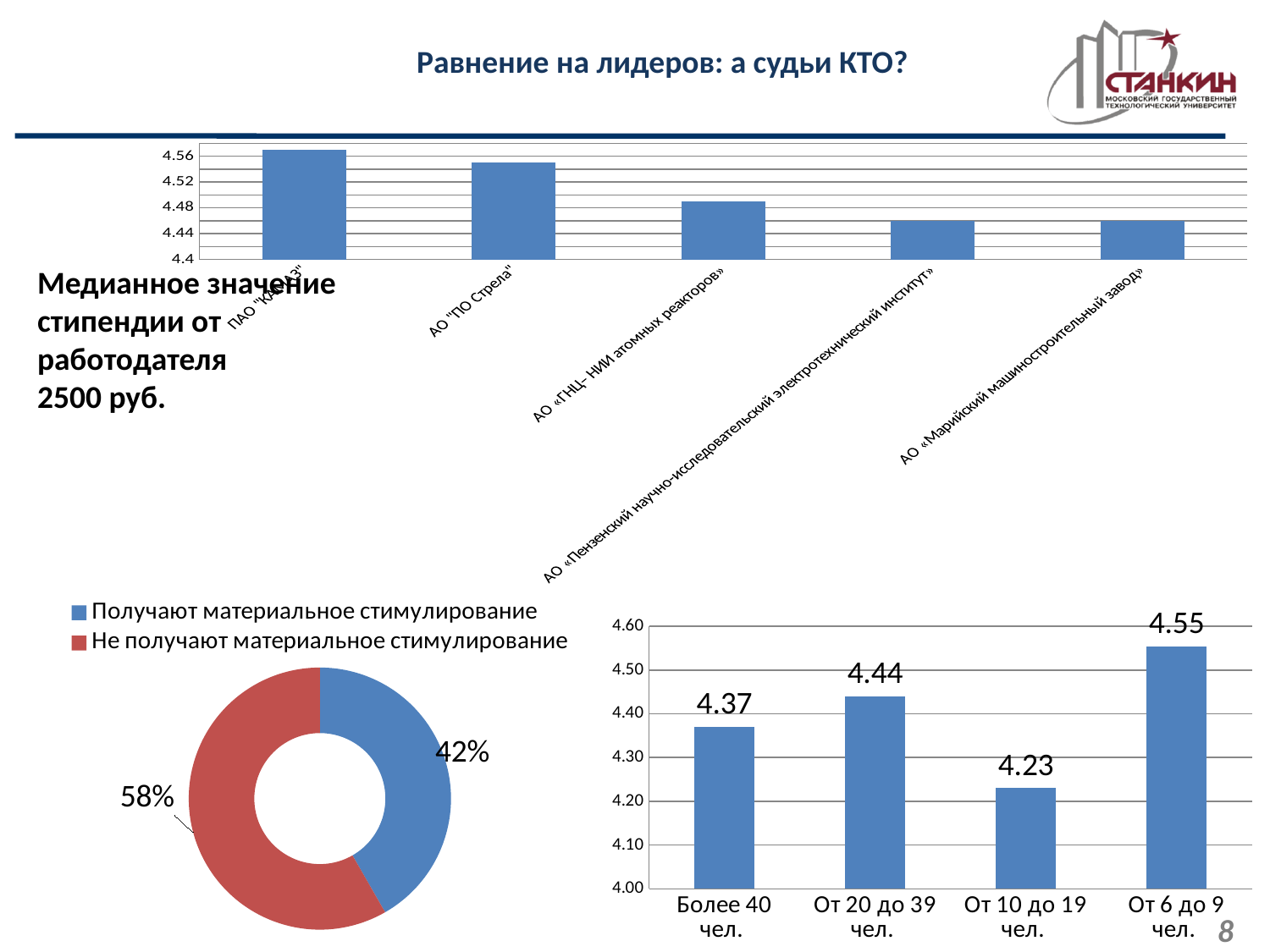
How many categories are shown in the bottom-right bar chart? 4 In the bottom-right bar chart, what is the difference between the values for 'От 6 до 9 чел.' and 'От 10 до 19 чел.'? 0.32 In the top bar chart, is the value for АО "ПО Стрела" greater or less than 4.52? greater In the bottom-left donut chart, what share is 'Получают материальное стимулирование'? 42% How many entries does the legend of the bottom-left donut chart list? 2 In the top bar chart, is the value for АО «Марийский машиностроительный завод» greater or less than 4.48? less In the bottom-right bar chart, which category has the highest value? От 6 до 9 чел. In the bottom-left donut chart, what share is 'Не получают материальное стимулирование'? 58% In the bottom-right bar chart, what is the value for 'Более 40 чел.'? 4.37 In the bottom-right bar chart, which category has the lowest value? От 10 до 19 чел. In the bottom-right bar chart, which is larger: the value for 'Более 40 чел.' or 'От 20 до 39 чел.'? От 20 до 39 чел. In the bottom-right bar chart, what is the value for 'От 10 до 19 чел.'? 4.23